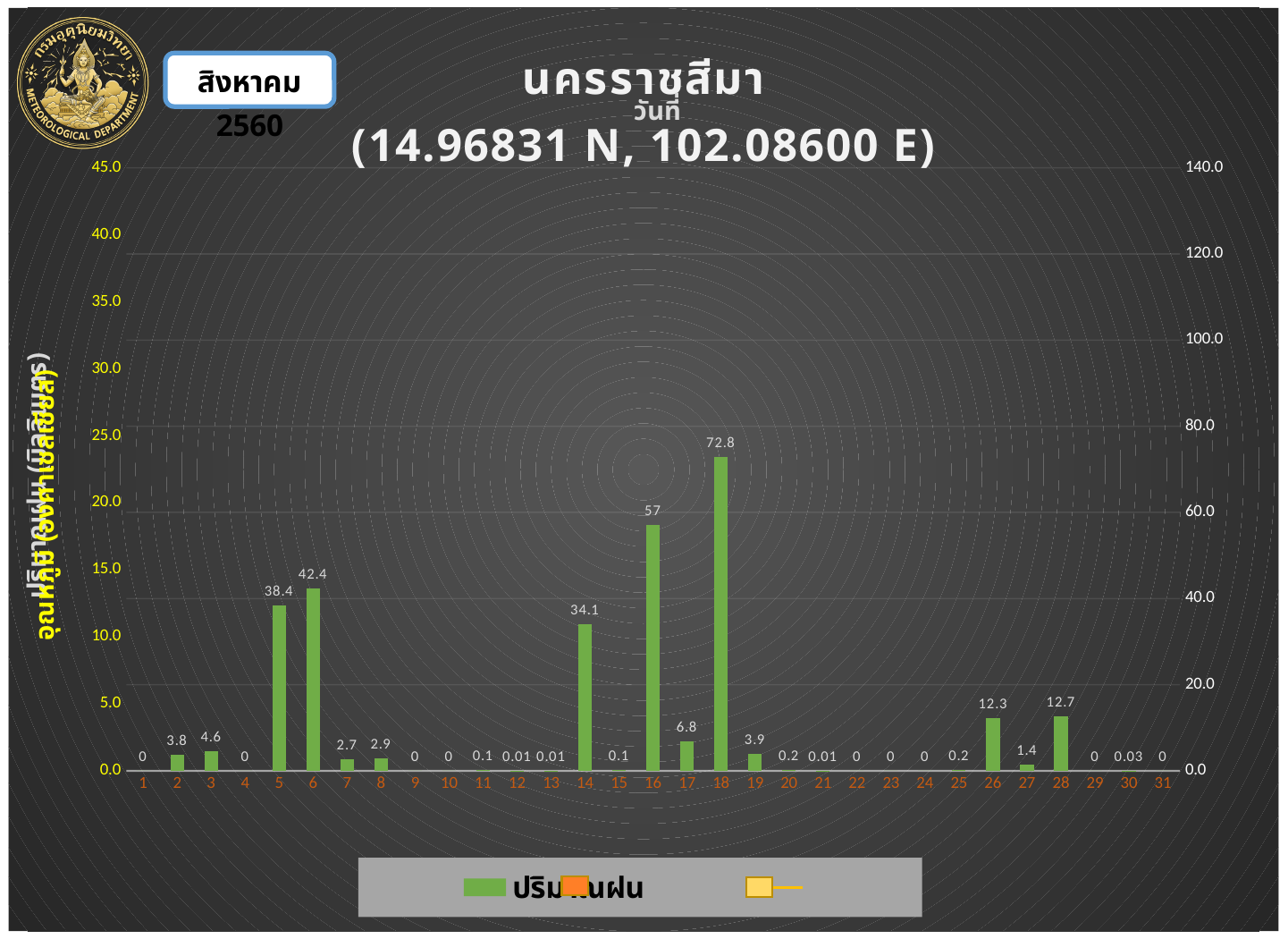
Is the rainfall value for day 18 greater or less than 60.0 on the right axis? greater What is the difference between the rainfall values for day 18 and day 16? 15.8 How many days are shown on the x axis? 31 What is the rainfall value for day 16? 57 What is the rainfall value for day 18? 72.8 Which is larger, the rainfall value for day 14 or for day 28? day 14 What kind of chart is shown on the slide? bar chart What is the difference between the rainfall values for day 6 and day 5? 4 What is the name of the province shown in the chart title? นครราชสีมา What is the rainfall value for day 5? 38.4 What is the rainfall value for day 26? 12.3 Which day has the highest rainfall value? 18